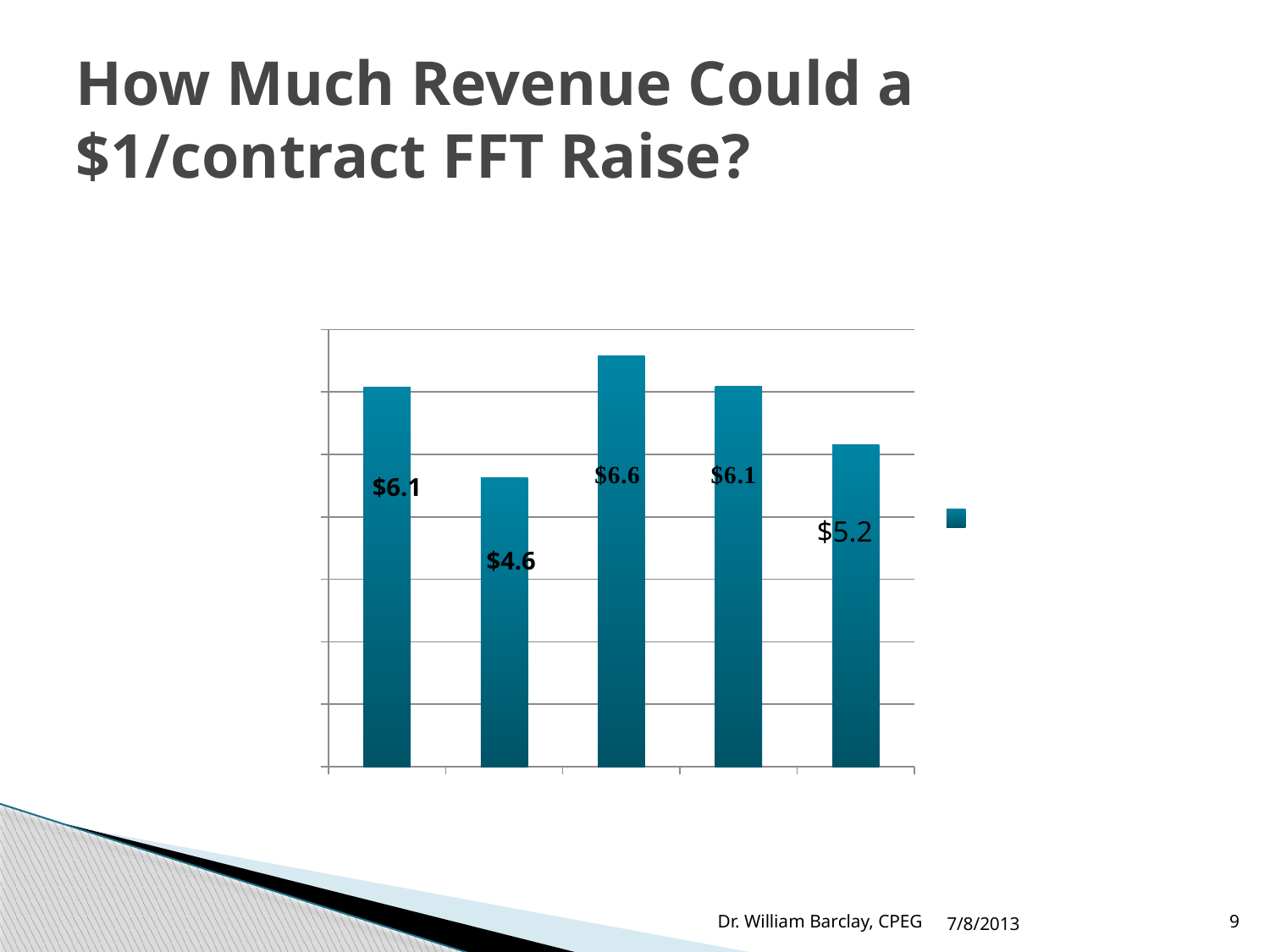
What is the value labelled on the fifth (rightmost) bar? $5.2 What kind of chart is shown on the slide? bar chart How many bars are plotted in the chart? 5 Which bar has the lowest value? the second bar ($4.6) What is the difference between the fourth bar ($6.1) and the fifth bar ($5.2)? $0.9 What is the title of the slide containing the chart? How Much Revenue Could a $1/contract FFT Raise? What is the difference between the highest bar ($6.6) and the lowest bar ($4.6)? $2.0 What is the value labelled on the second bar from the left? $4.6 Which bar has the highest value? the third bar ($6.6) What is the value labelled on the third bar from the left? $6.6 Which is larger, the value of the second bar or the value of the fifth bar? the fifth bar ($5.2) What is the value labelled on the first (leftmost) bar? $6.1